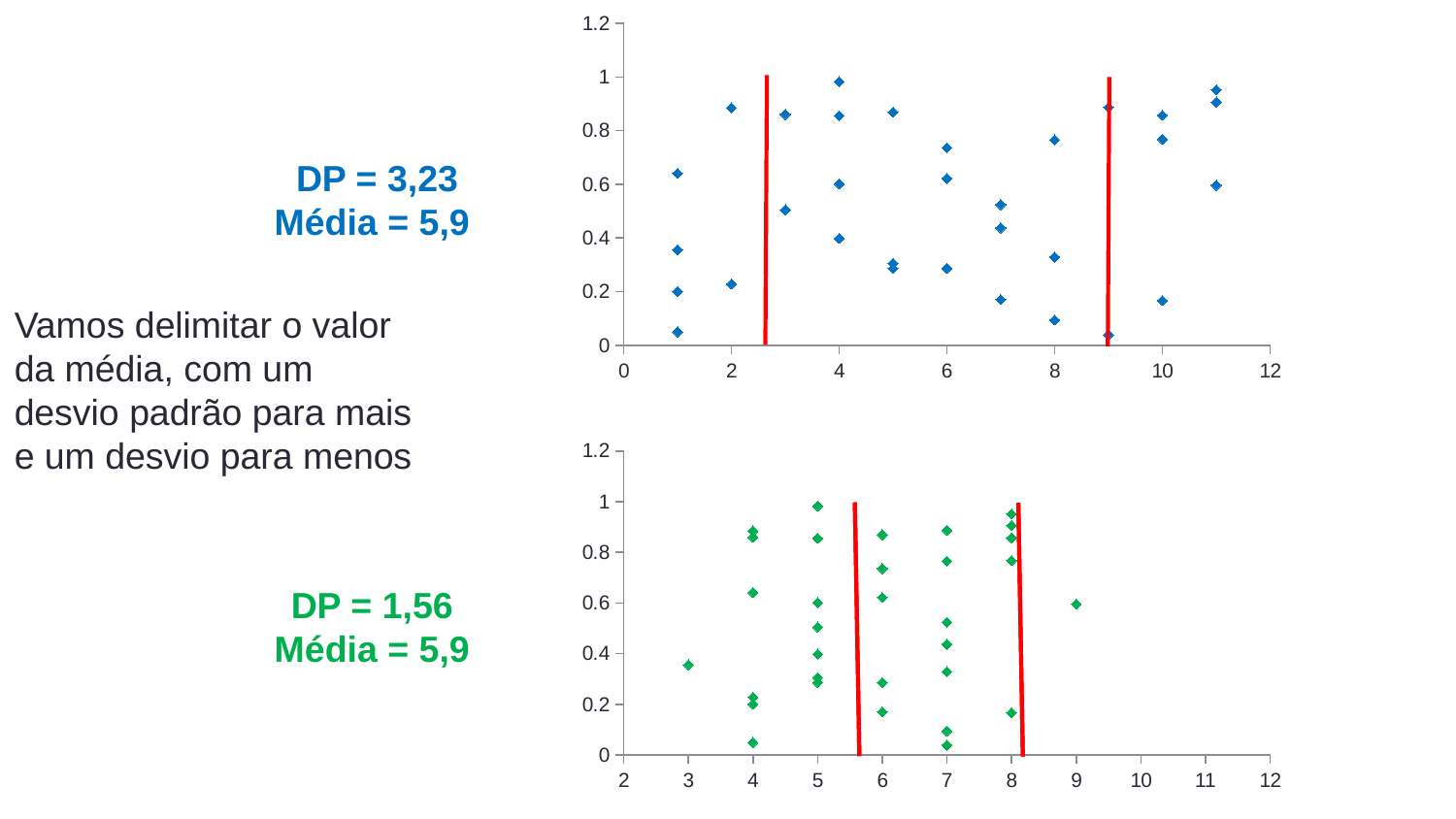
In the top chart, how many points are plotted at x = 2? 2 In the top chart, how many red vertical lines are drawn? 2 In the top chart, is the lowest point at x = 1 greater or less than 0.2? less In the bottom chart, is the point at x = 3 greater or less than 0.6? less How many charts are shown on the slide? 2 In the bottom chart, is the point at x = 9 greater or less than 0.4? greater What kind of chart is the bottom chart on the slide? scatter chart What kind of chart is the top chart on the slide? scatter chart In the bottom chart, what is the lowest value shown on the x axis? 2 In the top chart, what is the highest value shown on the x axis? 12